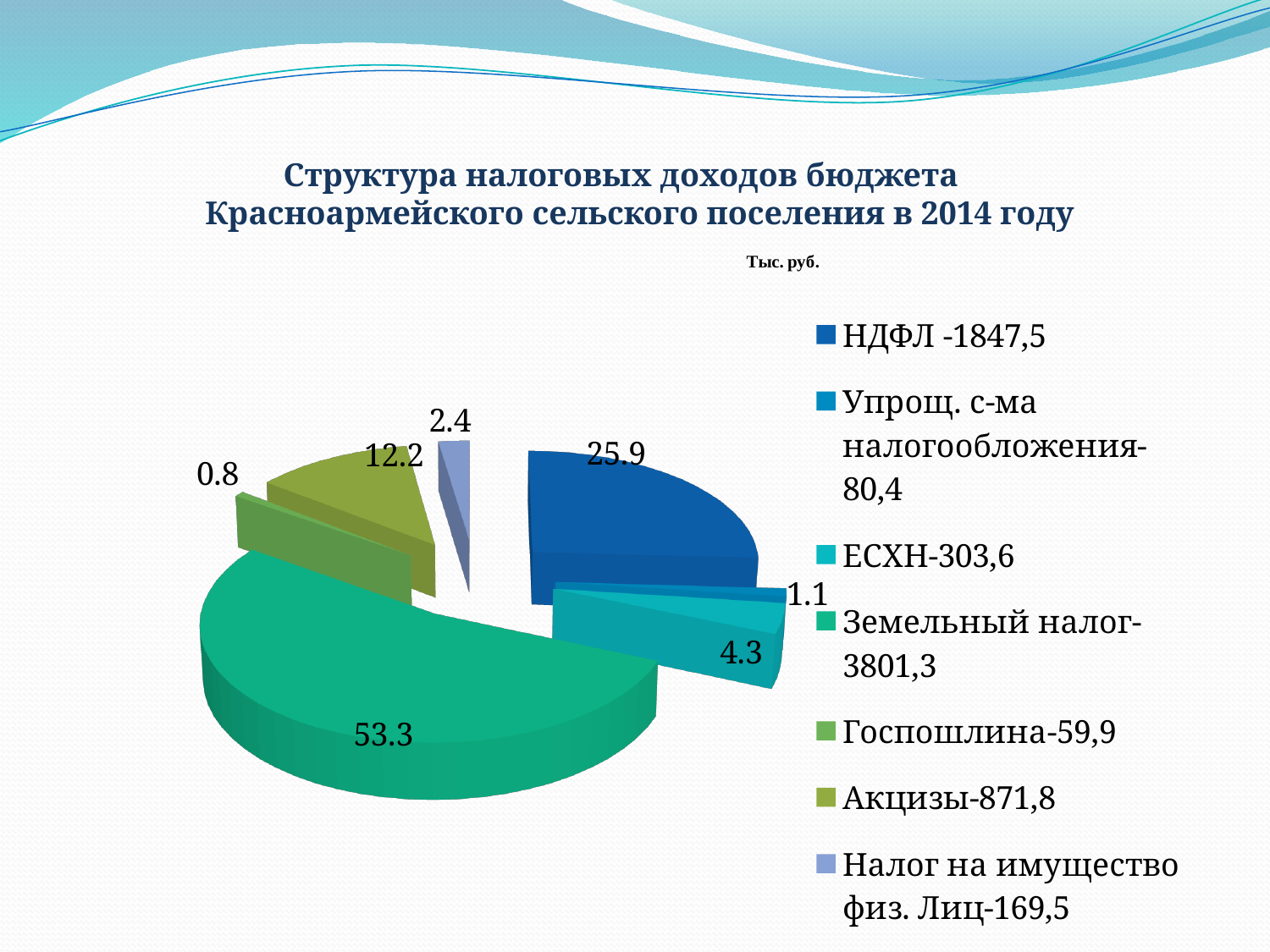
Which category has the smallest slice of the pie? Госпошлина Which category has the largest slice of the pie? Земельный налог What is the data label on the slice for НДФЛ? 25.9 Which slice is larger, НДФЛ or Акцизы? НДФЛ What is the data label on the slice for ЕСХН? 4.3 What kind of chart is shown on the slide? Pie chart What amount is shown in the legend for Земельный налог? 3801,3 What is the data label on the slice for Акцизы? 12.2 How many slices does the pie chart have? 7 What is the data label on the slice for Земельный налог? 53.3 What is the difference between the data labels for Земельный налог and НДФЛ? 27.4 What is the data label on the slice for Госпошлина? 0.8